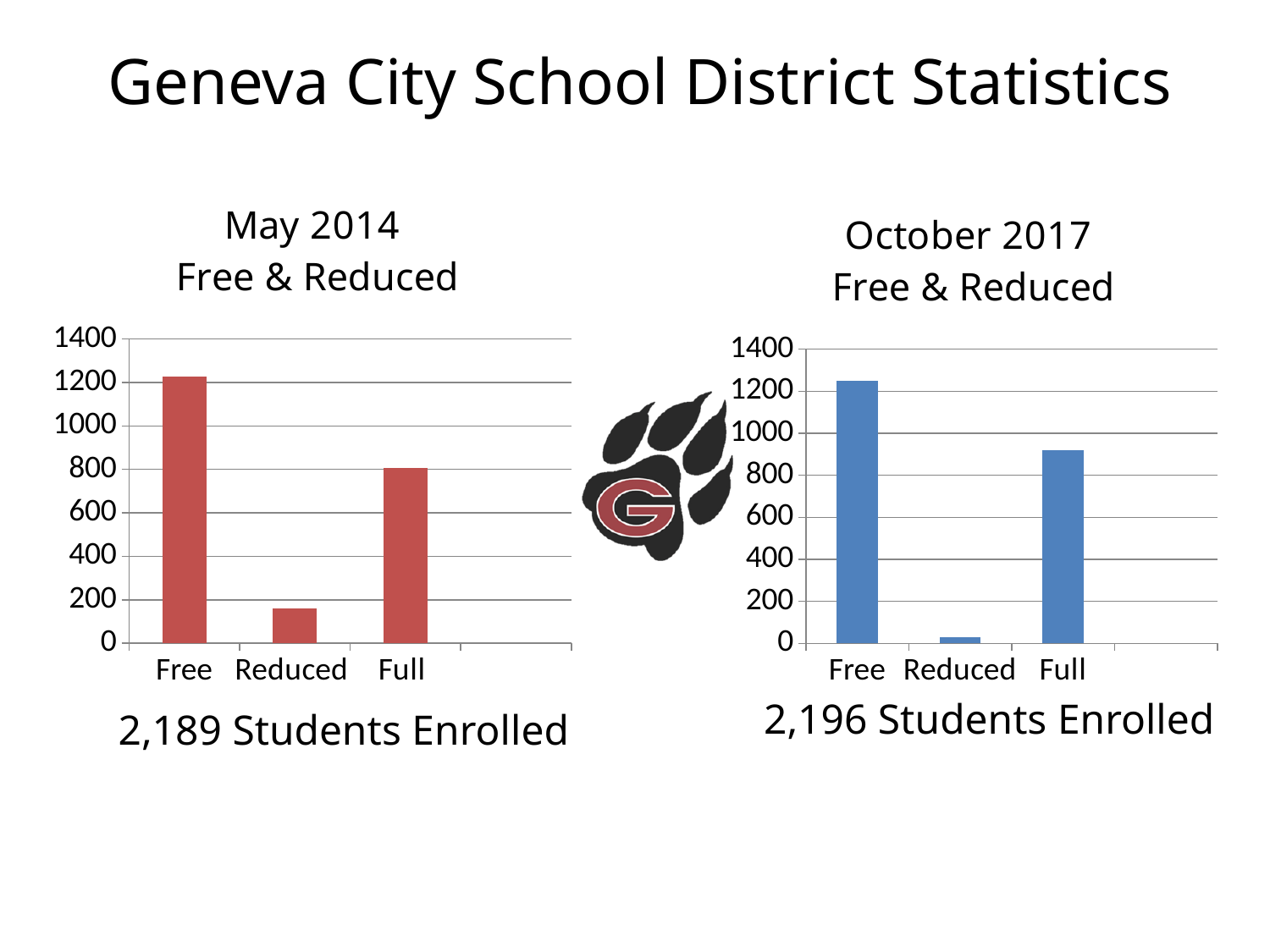
In the October 2017 Free & Reduced chart, is the value for Full greater or less than 800? greater In the May 2014 Free & Reduced chart, which category has the highest value? Free In the May 2014 Free & Reduced chart, is the value for Reduced greater or less than 200? less How many categories are shown on the x axis of the October 2017 Free & Reduced chart? 3 What kind of chart is the May 2014 Free & Reduced chart? Bar chart In the May 2014 Free & Reduced chart, which category has the lowest value? Reduced In the May 2014 Free & Reduced chart, is the value for Free greater or less than 1200? greater In the October 2017 Free & Reduced chart, which category has the lowest value? Reduced In the May 2014 Free & Reduced chart, which is larger, the value for Full or the value for Reduced? Full What colour are the bars in the October 2017 Free & Reduced chart? Blue In the October 2017 Free & Reduced chart, which category has the highest value? Free